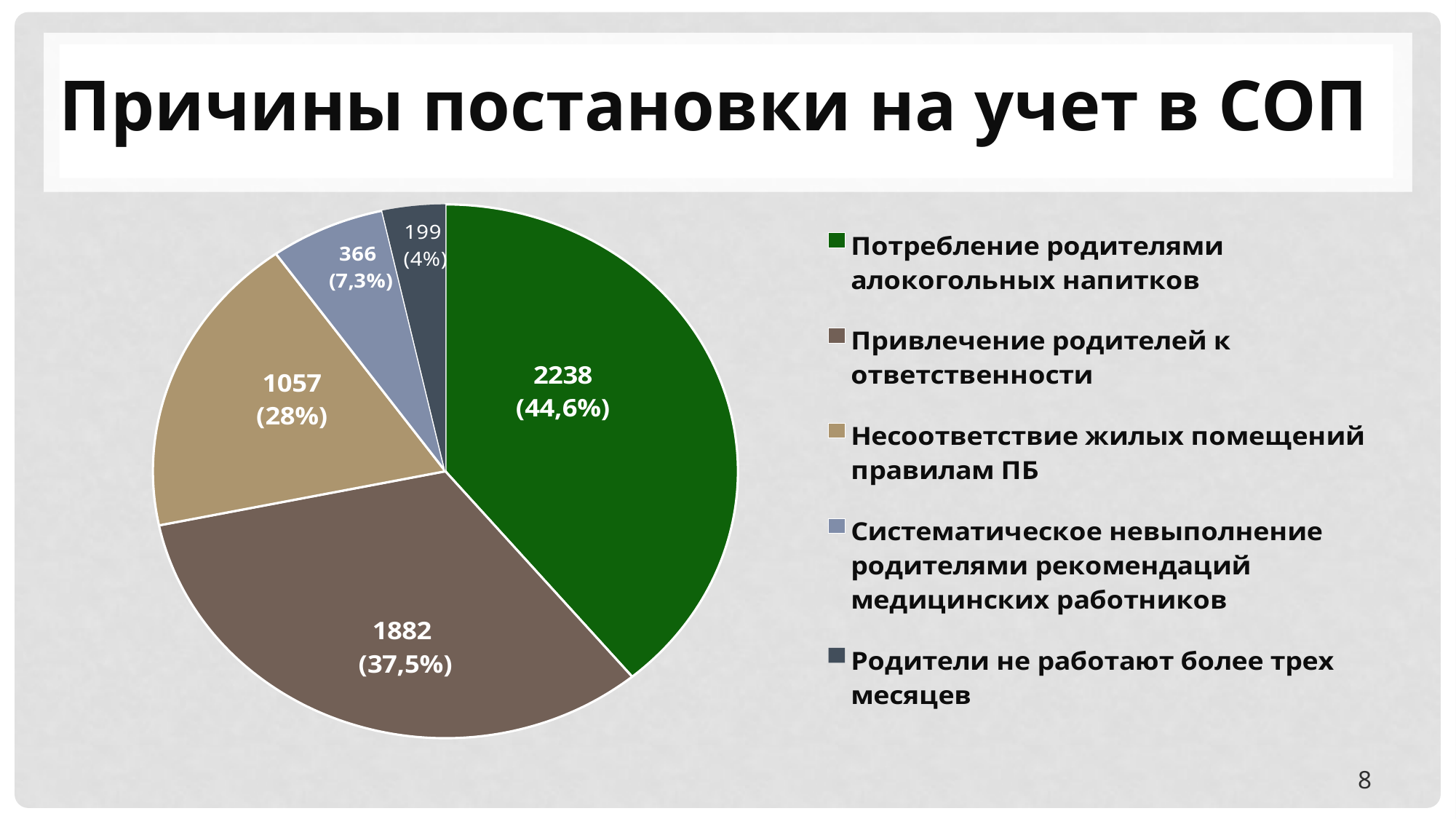
Какое значение указано для категории «Привлечение родителей к ответственности»? 1882 Какая категория имеет наибольшее значение? Потребление родителями алокогольных напитков Какая категория больше: «Несоответствие жилых помещений правилам ПБ» или «Систематическое невыполнение родителями рекомендаций медицинских работников»? Несоответствие жилых помещений правилам ПБ На сколько значение категории «Потребление родителями алокогольных напитков» больше значения категории «Привлечение родителей к ответственности»? 356 Какой тип диаграммы показан на слайде? Круговая диаграмма Какая категория имеет наименьшее значение? Родители не работают более трех месяцев Какое значение указано для категории «Потребление родителями алокогольных напитков»? 2238 Сколько категорий (секторов) показано на круговой диаграмме? 5 Какое значение указано для категории «Родители не работают более трех месяцев»? 199 Какая доля в процентах указана для категории «Потребление родителями алокогольных напитков»? 44,6% Какая доля в процентах указана для категории «Систематическое невыполнение родителями рекомендаций медицинских работников»? 7,3% Какое значение указано для категории «Несоответствие жилых помещений правилам ПБ»? 1057